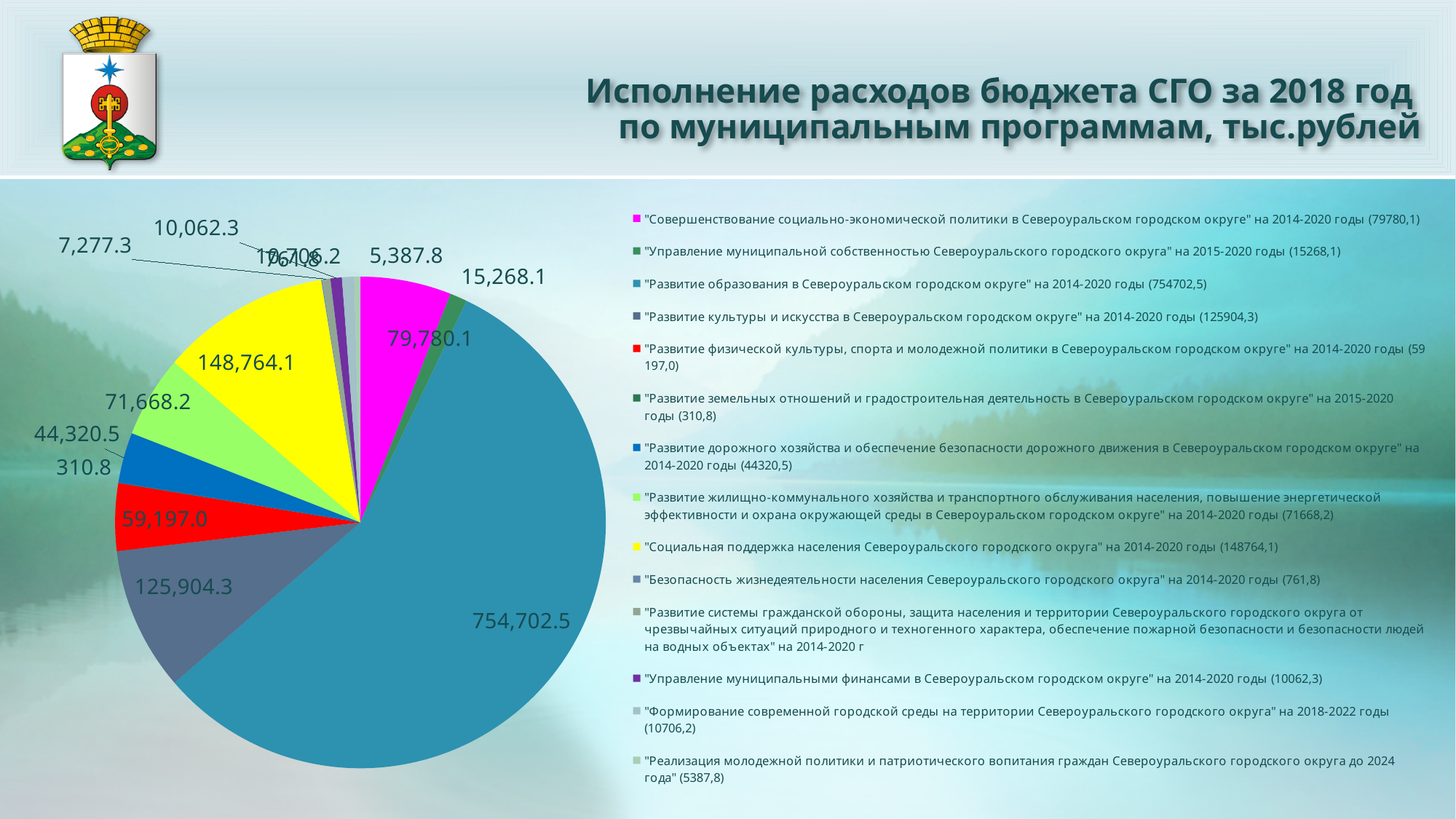
What is the value shown for "Социальная поддержка населения Североуральского городского округа"? 148,764.1 Which is larger: the value for "Совершенствование социально-экономической политики" or for "Развитие жилищно-коммунального хозяйства"? "Совершенствование социально-экономической политики" (79,780.1) What is the value of the largest slice, for "Развитие образования"? 754,702.5 Which programme has the largest slice of the pie? "Развитие образования в Североуральском городском округе" на 2014-2020 годы What is the value shown for "Развитие культуры и искусства в Североуральском городском округе"? 125,904.3 What kind of chart is shown on the slide? pie chart What is the value shown for "Развитие дорожного хозяйства и обеспечение безопасности дорожного движения"? 44,320.5 What is the title of the chart on the slide? Исполнение расходов бюджета СГО за 2018 год по муниципальным программам, тыс.рублей Which programme has the smallest value on the chart? "Развитие земельных отношений и градостроительная деятельность" (310.8) What is the difference between the values for "Социальная поддержка населения" (148,764.1) and "Развитие культуры и искусства" (125,904.3)? 22,859.8 How many programmes (slices) does the legend list? 14 What is the difference between the values for "Развитие физической культуры, спорта и молодежной политики" (59,197.0) and "Развитие дорожного хозяйства" (44,320.5)? 14,876.5